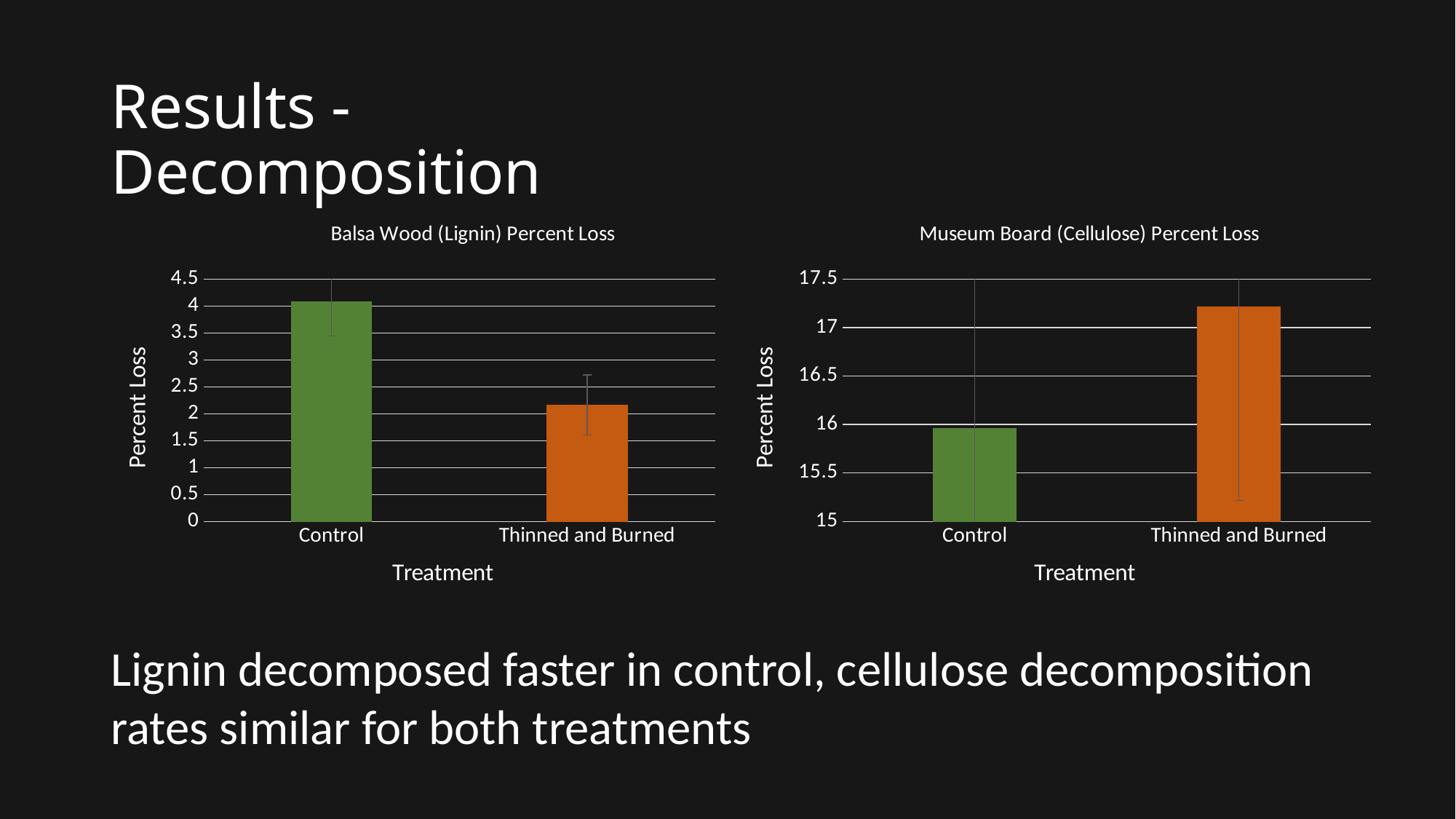
In the Museum Board (Cellulose) Percent Loss chart, is the value for Thinned and Burned greater or less than 17? greater In the Balsa Wood (Lignin) Percent Loss chart, is the value for Thinned and Burned greater or less than 2.5? less What kind of chart is the Balsa Wood (Lignin) Percent Loss chart? bar chart In the Balsa Wood (Lignin) Percent Loss chart, which treatment has the lower percent loss? Thinned and Burned In the Balsa Wood (Lignin) Percent Loss chart, which treatment has the higher percent loss? Control In the Balsa Wood (Lignin) Percent Loss chart, is the value for Control greater or less than 3.5? greater In the Museum Board (Cellulose) Percent Loss chart, which treatment has the lower percent loss? Control What is the label on the x axis of the Museum Board (Cellulose) Percent Loss chart? Treatment How many treatment categories are shown in the Museum Board (Cellulose) Percent Loss chart? 2 In the Balsa Wood (Lignin) Percent Loss chart, is the value for Control larger or smaller than the value for Thinned and Burned? larger In the Museum Board (Cellulose) Percent Loss chart, which treatment has the higher percent loss? Thinned and Burned